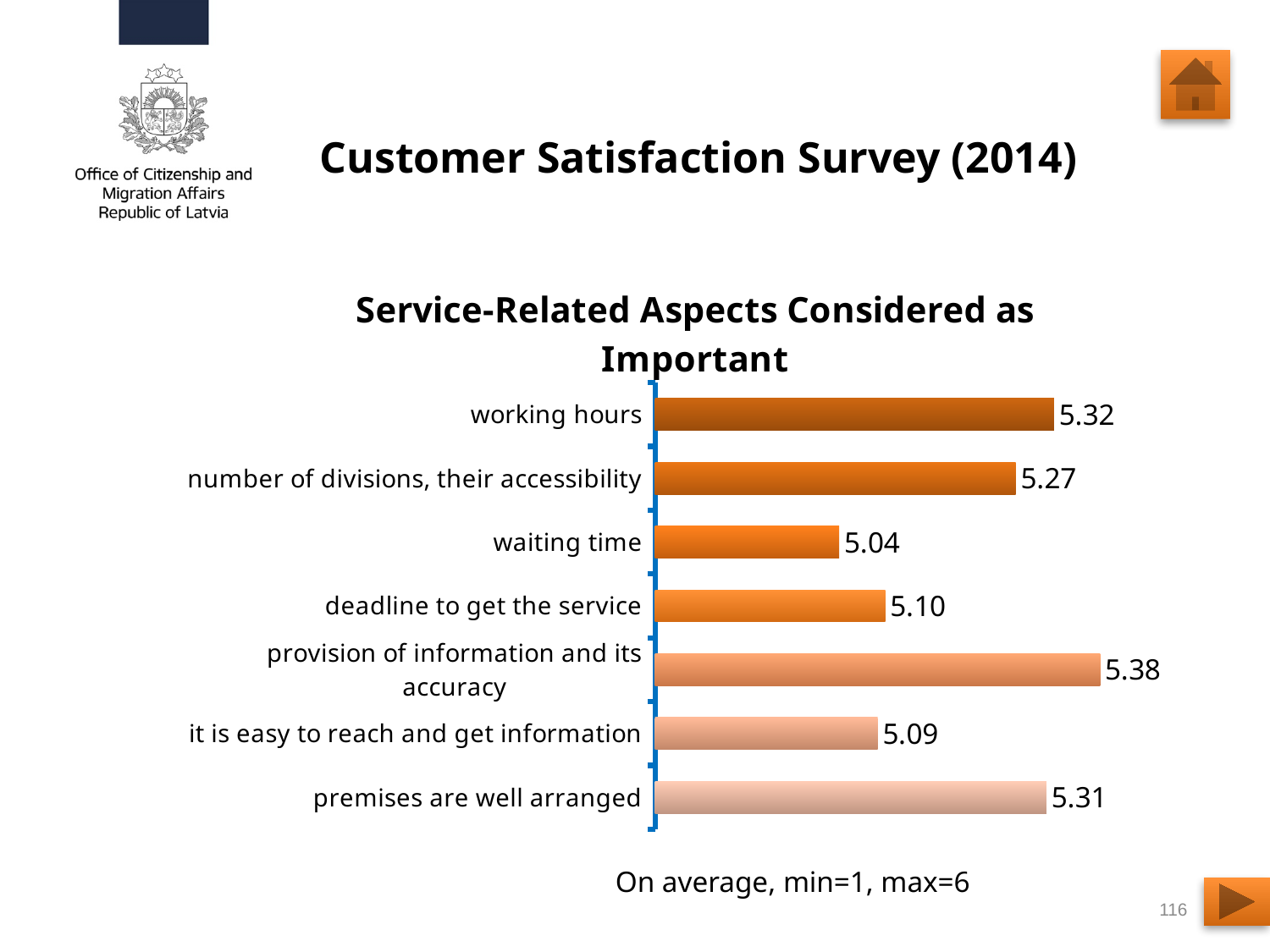
Which aspect has the lowest value? waiting time Which aspect has the highest value? provision of information and its accuracy What is the value for "working hours"? 5.32 What is the difference between the values for "number of divisions, their accessibility" and "deadline to get the service"? 0.17 Which is larger: the value for "deadline to get the service" or the value for "it is easy to reach and get information"? deadline to get the service What is the value for "premises are well arranged"? 5.31 What is the difference between the values for "working hours" and "waiting time"? 0.28 What is the title of the chart? Service-Related Aspects Considered as Important What is the value for "provision of information and its accuracy"? 5.38 What kind of chart is shown on the slide? bar chart How many aspects (categories) are shown in the chart? 7 What is the value for "waiting time"? 5.04